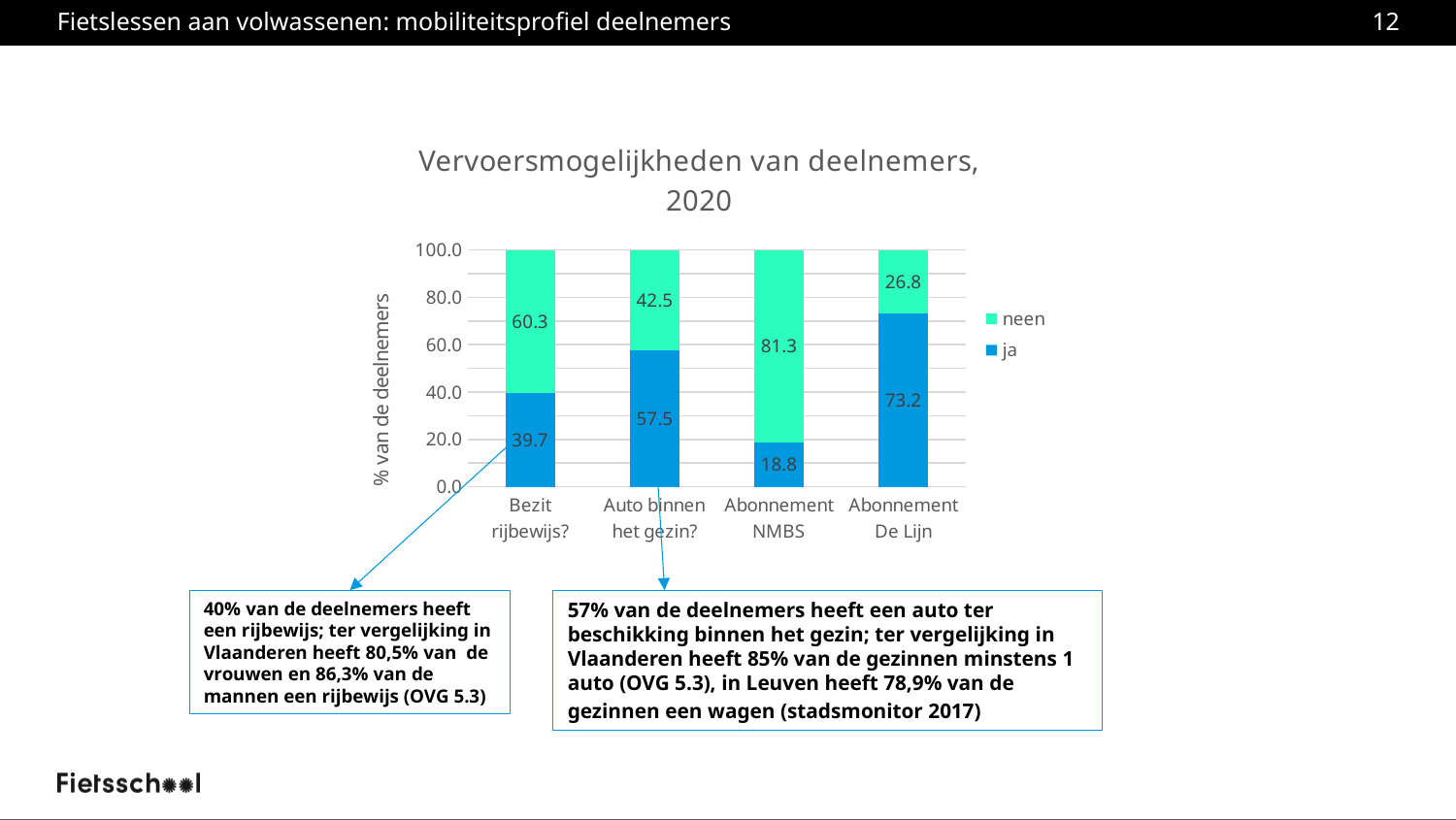
Which is larger: the 'ja' value for 'Auto binnen het gezin?' or the 'ja' value for 'Bezit rijbewijs?'? Auto binnen het gezin? What is the value of the 'ja' series for 'Abonnement De Lijn'? 73.2 Which category has the lowest 'ja' value? Abonnement NMBS Which category has the highest 'ja' value? Abonnement De Lijn What is the value of the 'neen' series for 'Auto binnen het gezin?'? 42.5 How many categories are shown on the x axis? 4 What is the title of the chart? Vervoersmogelijkheden van deelnemers, 2020 What is the difference between the 'neen' and 'ja' values for 'Bezit rijbewijs?'? 20.6 What is the value of the 'neen' series for 'Abonnement NMBS'? 81.3 What kind of chart is shown on the slide? Stacked bar chart What is the value of the 'ja' series for 'Bezit rijbewijs?'? 39.7 How many series does the legend list? 2